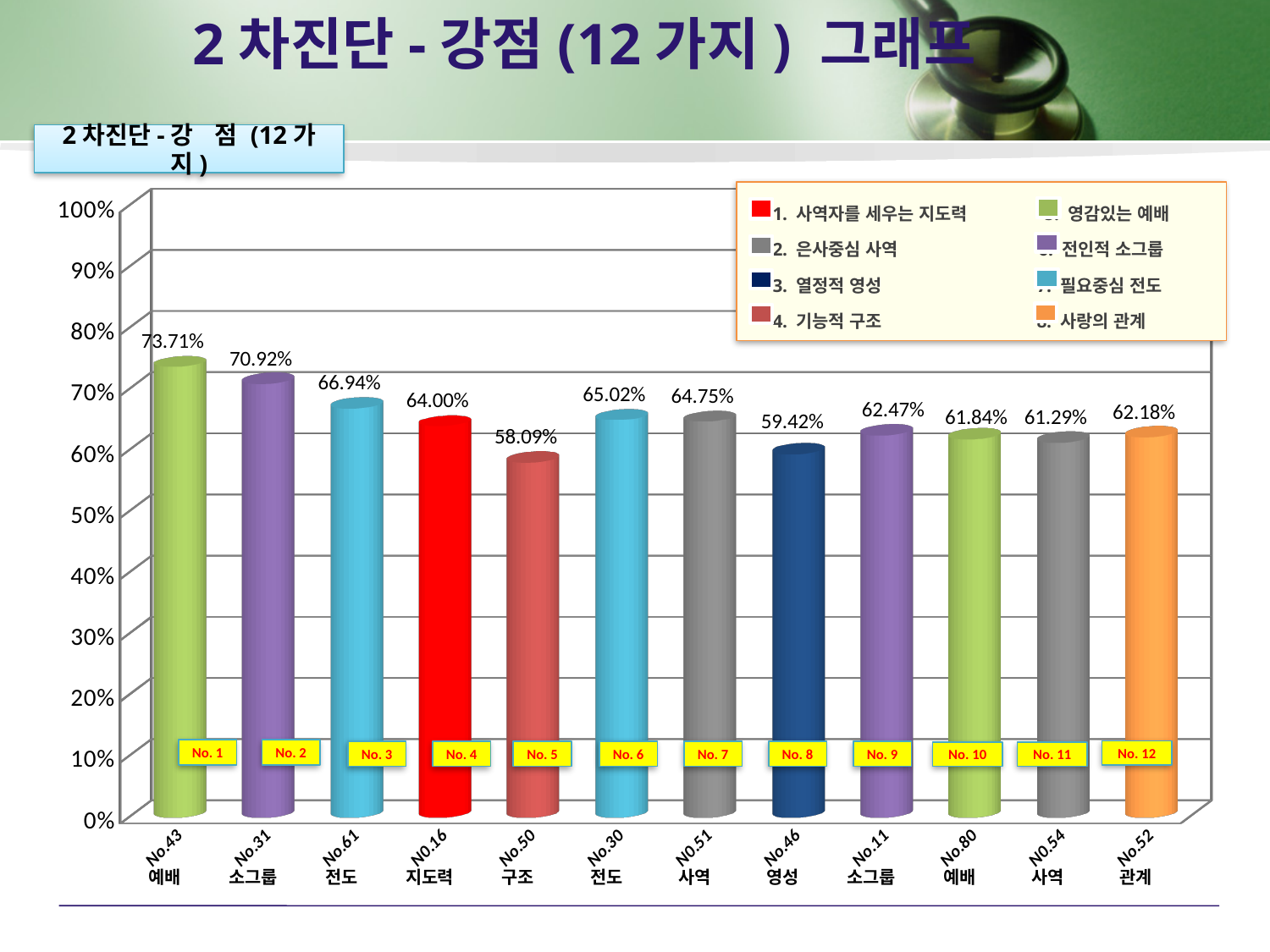
Is the value for No.46 영성 (No. 8) greater or less than 60%? less Which bar has the highest value? No.43 예배 (No. 1), 73.71% What kind of chart is shown on the slide? Bar chart How many bars are plotted in the chart? 12 What is the highest value shown on the vertical axis? 100% Which bar has the lowest value? No.50 구조 (No. 5), 58.09% Which is larger, the value for No.30 전도 (No. 6) or the value for N0.51 사역 (No. 7)? No.30 전도 (No. 6), 65.02% What is the value for the bar labelled No.52 관계 (No. 12)? 62.18% What is the difference between the values for No.43 예배 (No. 1) and No.31 소그룹 (No. 2)? 2.79% How many entries does the legend list? 8 What is the value for the bar labelled No.43 예배 (No. 1)? 73.71% What is the value for the bar labelled No.50 구조 (No. 5)? 58.09%